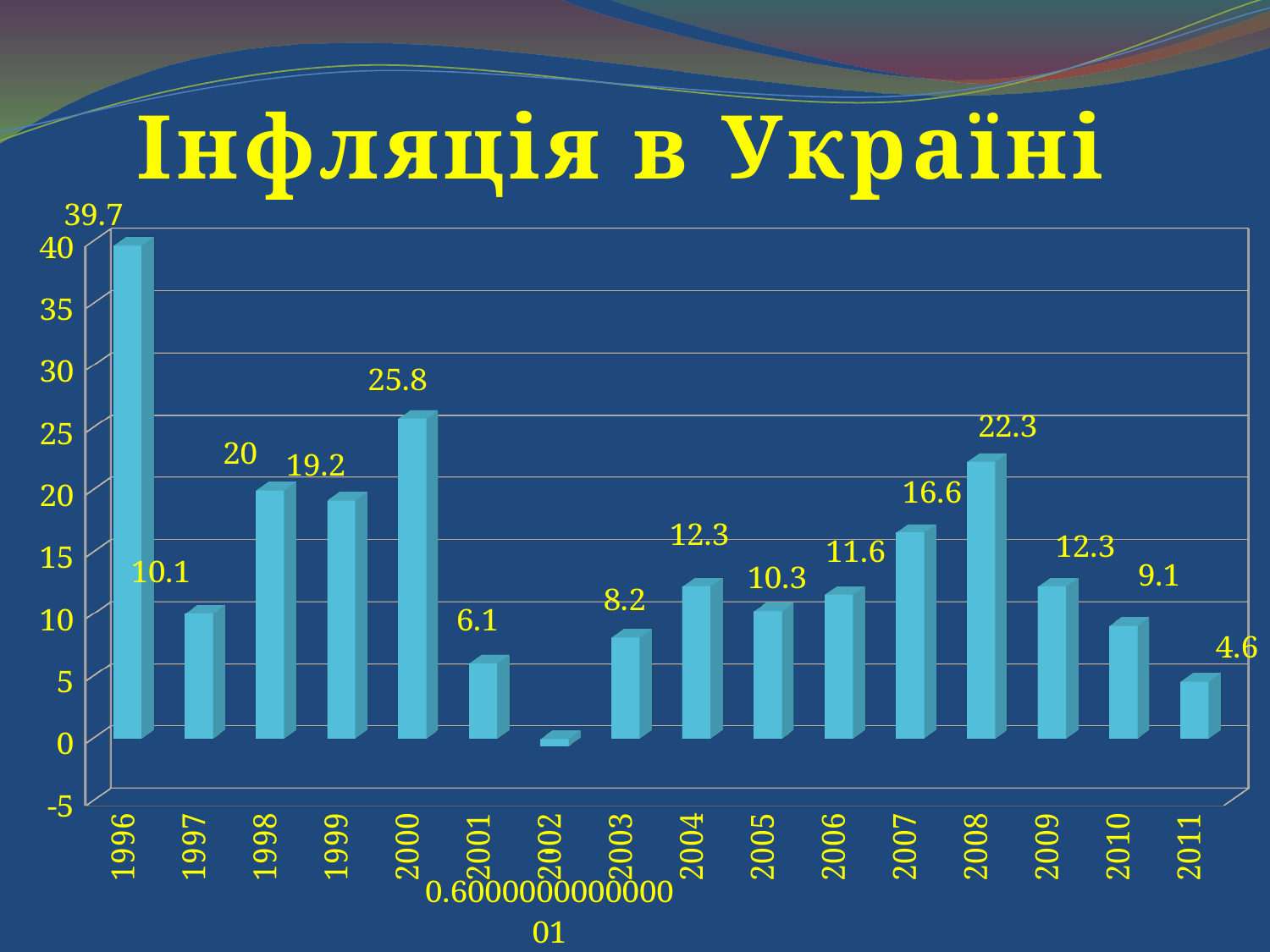
What is the value shown for 2000? 25.8 How many years are shown on the x axis? 16 Which year has the lowest value? 2002 Is the value for 1998 greater or less than 15? greater What is the title of the chart? Інфляція в Україні What is the inflation value shown for 1996? 39.7 What is the value shown for 2008? 22.3 What is the value shown for 2011? 4.6 What kind of chart is shown on the slide? bar chart What is the difference between the values for 1996 and 2000? 13.9 Which is larger, the value for 2007 or the value for 2009? 2007 Which year has the highest value? 1996